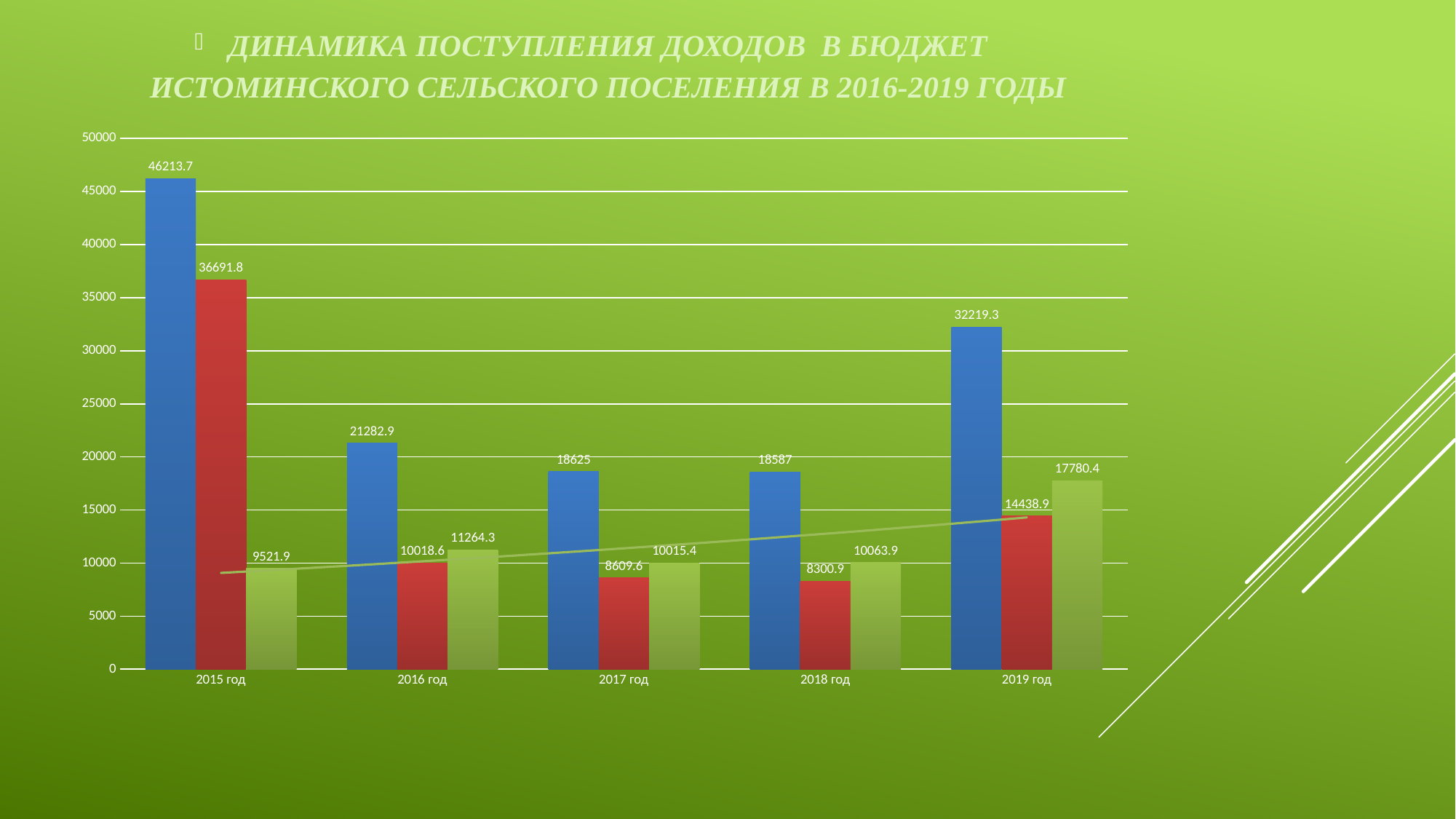
What is the value of the green bar for 2017 год? 10015.4 Is the value of the blue bar for 2019 год greater or less than 30000? greater How many bars are shown for each year? 3 What is the value of the blue bar for 2015 год? 46213.7 In which year is the blue bar the highest? 2015 год In which year is the red bar the lowest? 2018 год Which is larger for 2016 год, the red bar or the green bar? the green bar How many years are shown on the x axis? 5 What is the difference between the blue bar values for 2015 год and 2019 год? 13994.4 Does the blue bar rise or fall from 2015 год to 2018 год? fall What is the value of the red bar for 2019 год? 14438.9 What kind of chart is shown on the slide? bar chart